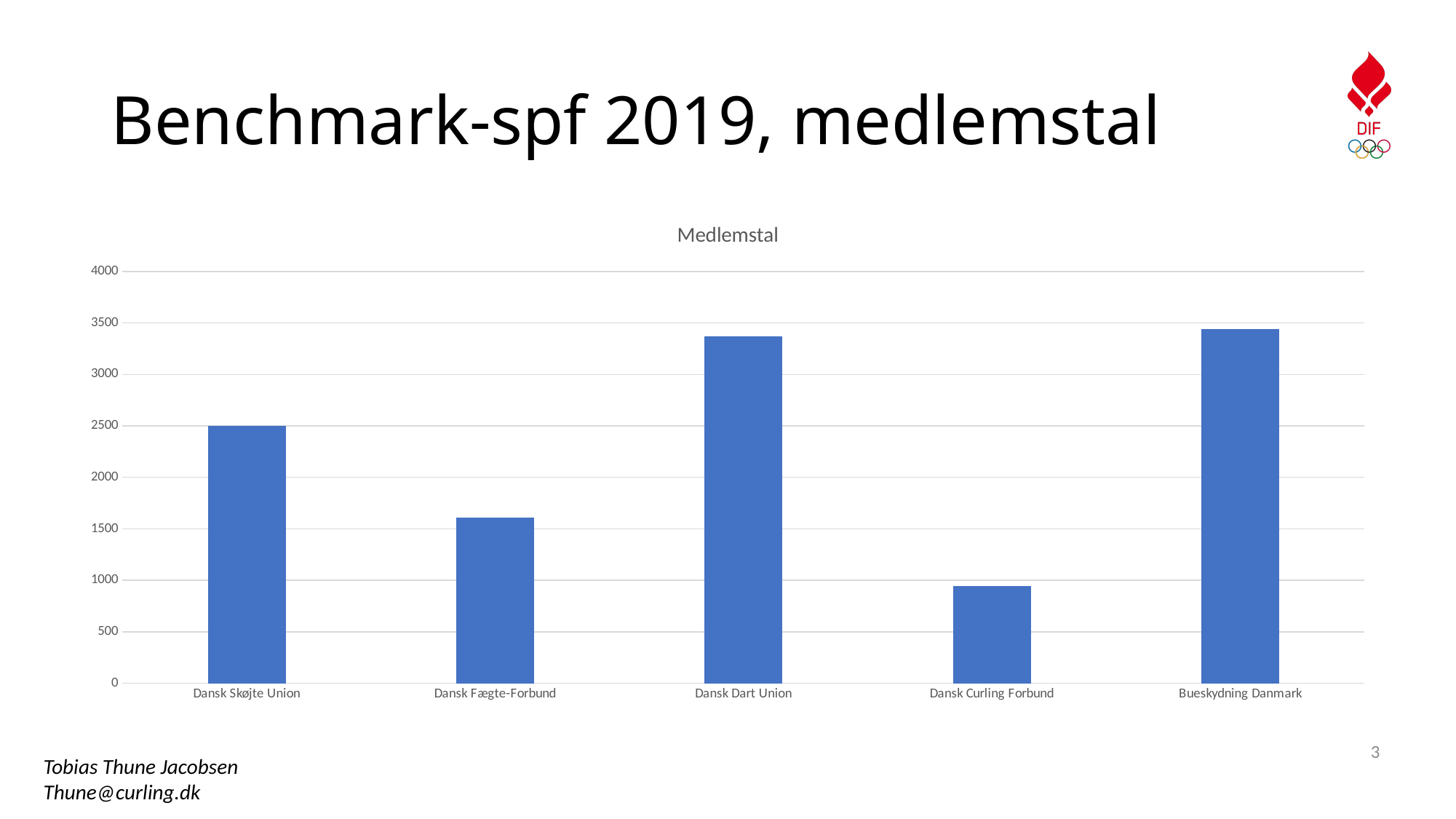
Which is larger, the value for Dansk Skøjte Union or the value for Dansk Fægte-Forbund? Dansk Skøjte Union What kind of chart is shown on the slide? bar chart How many categories (federations) are shown in the chart? 5 Is the value for Dansk Dart Union greater or less than 3000? greater Which federation has the lowest value in the chart? Dansk Curling Forbund Which is larger, the value for Dansk Dart Union or the value for Dansk Curling Forbund? Dansk Dart Union Is the value for Dansk Skøjte Union greater or less than 2000? greater Is the value for Dansk Curling Forbund greater or less than 1000? less What colour are the bars in the chart? blue What is the title of the chart? Medlemstal